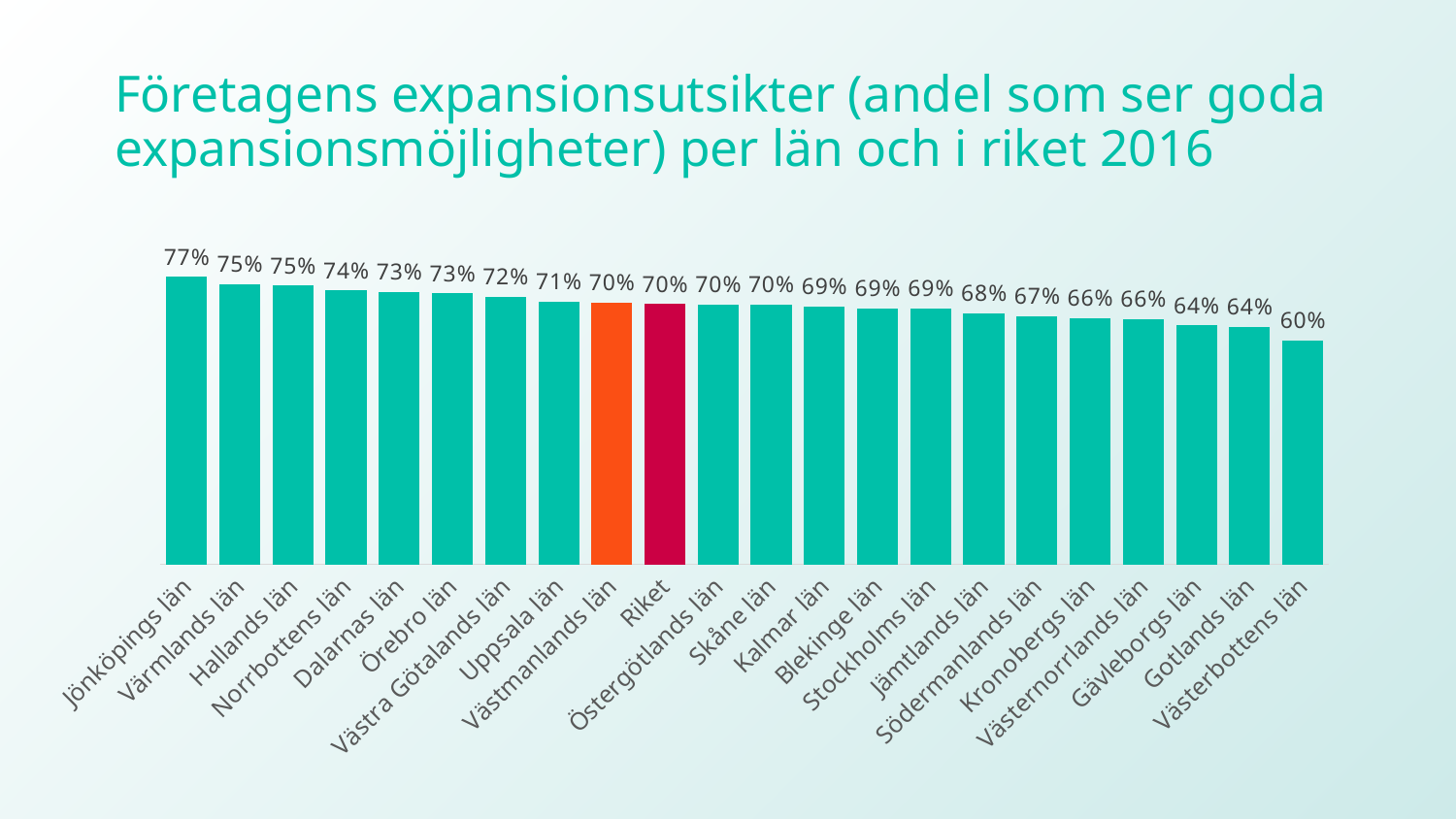
Which category has the highest value? Jönköpings län How many categories are shown in the chart? 22 What is the value for Riket? 70% What is the difference between the values for Norrbottens län and Riket? 4% What is the value for Gotlands län? 64% What is the value for Jönköpings län? 77% What is the difference between the values for Jönköpings län and Västerbottens län? 17% What is the value for Stockholms län? 69% Which is larger, the value for Uppsala län or the value for Jämtlands län? Uppsala län Which bar is coloured orange? Västmanlands län Which category has the lowest value? Västerbottens län What kind of chart is shown on the slide? Bar chart